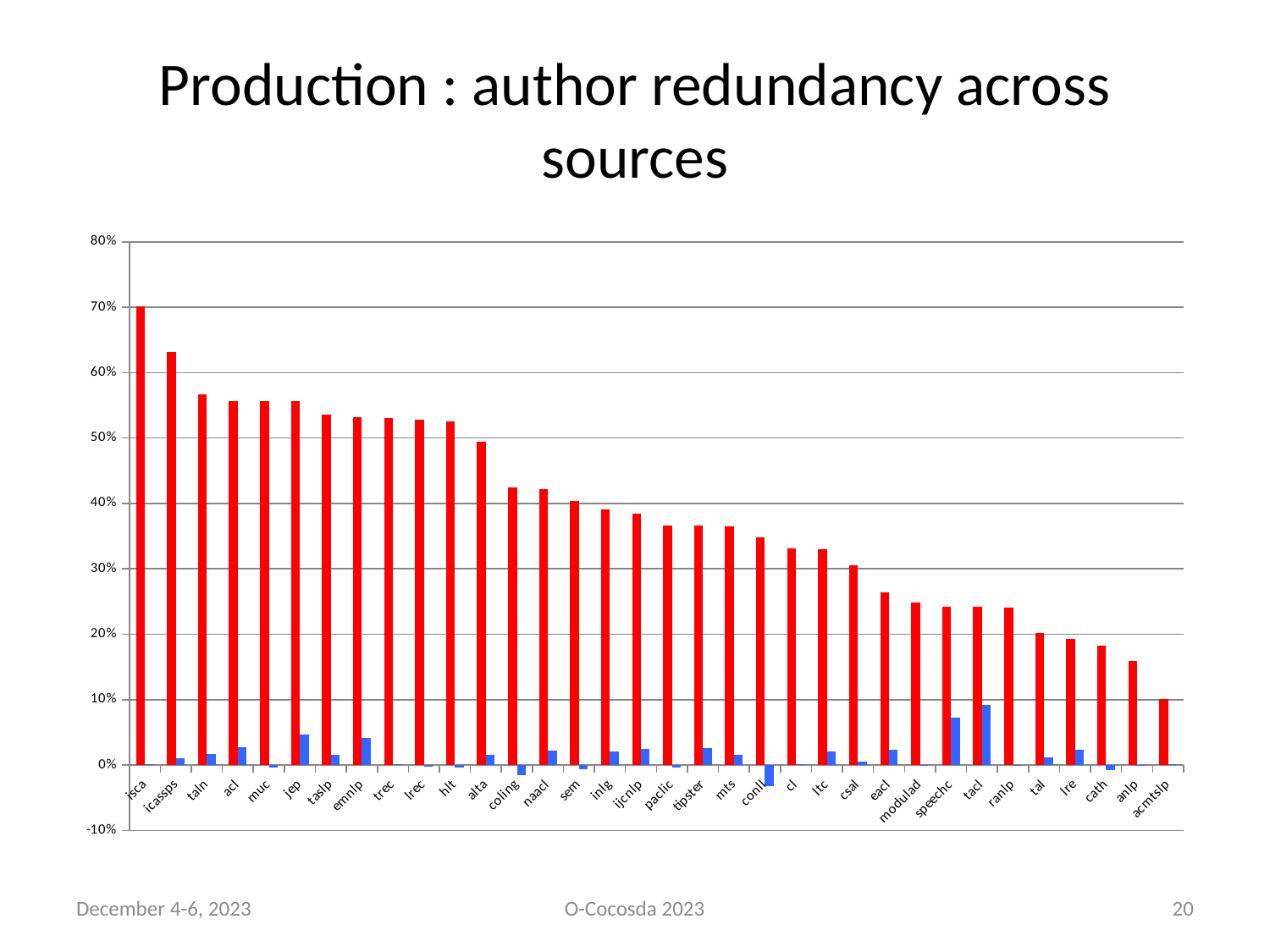
Do the red bars rise or fall from left to right along the x axis? fall Is the red bar for acmtslp greater or less than 20%? less Is the red bar for cl greater or less than 40%? less Is the red bar for isca greater or less than 60%? greater Which category has the tallest red bar? isca What kind of chart is shown on the slide? bar chart Which has the taller red bar, alta or coling? alta What is the title of the chart? Production : author redundancy across sources Which has the taller red bar, icassps or taln? icassps How many categories are shown on the x axis? 34 Which category has the shortest red bar? acmtslp